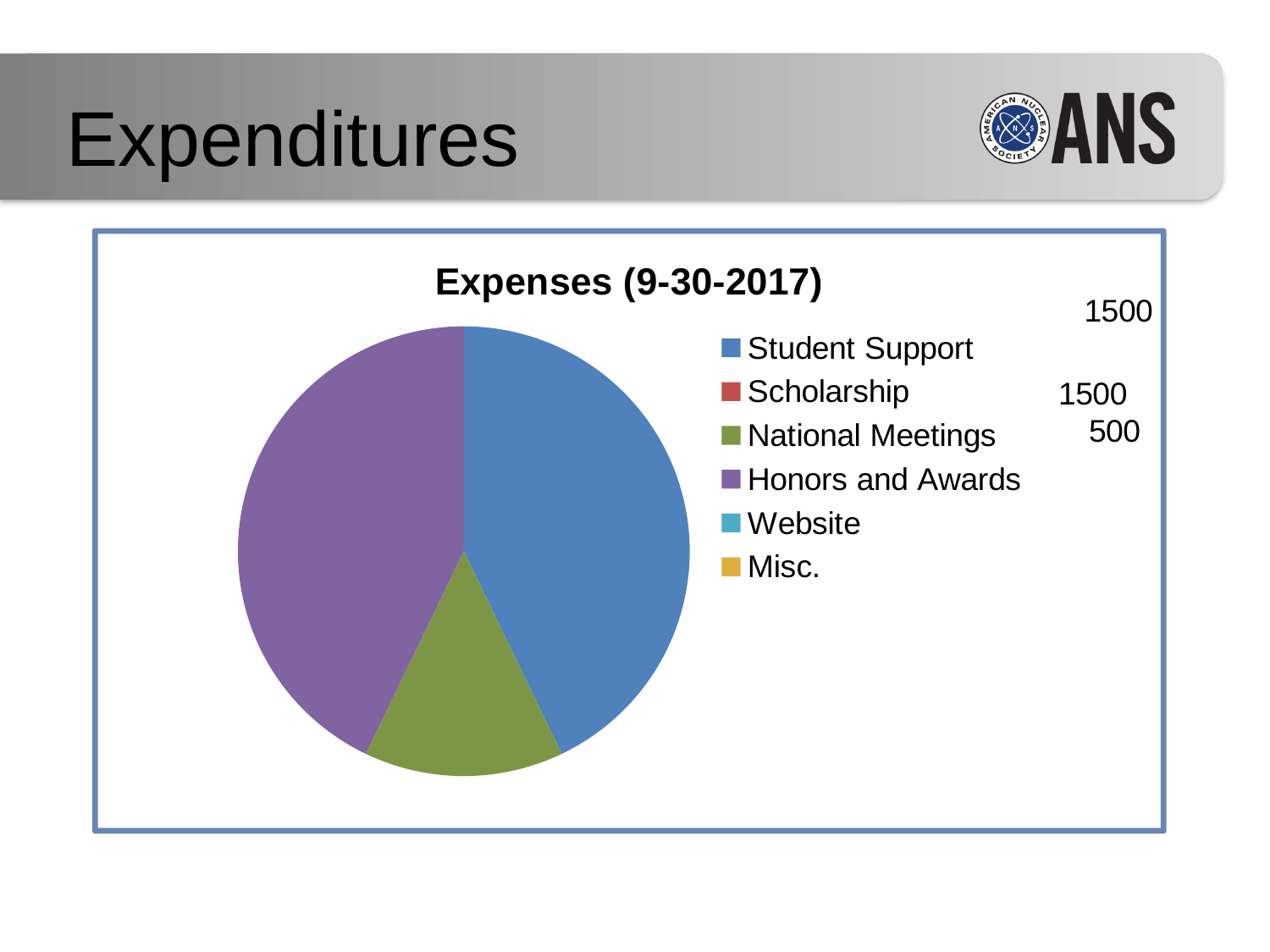
Which is larger, the slice for Honors and Awards or the slice for National Meetings? Honors and Awards Of the slices visible in the pie, which category has the smallest slice? National Meetings What kind of chart is shown on the slide? pie chart How many slices are visible in the pie? 3 What is the title of the chart? Expenses (9-30-2017) Which legend entry is listed last? Misc. Which category is shown in blue in the legend? Student Support How many categories does the legend list? 6 Which is larger, the slice for Student Support or the slice for National Meetings? Student Support